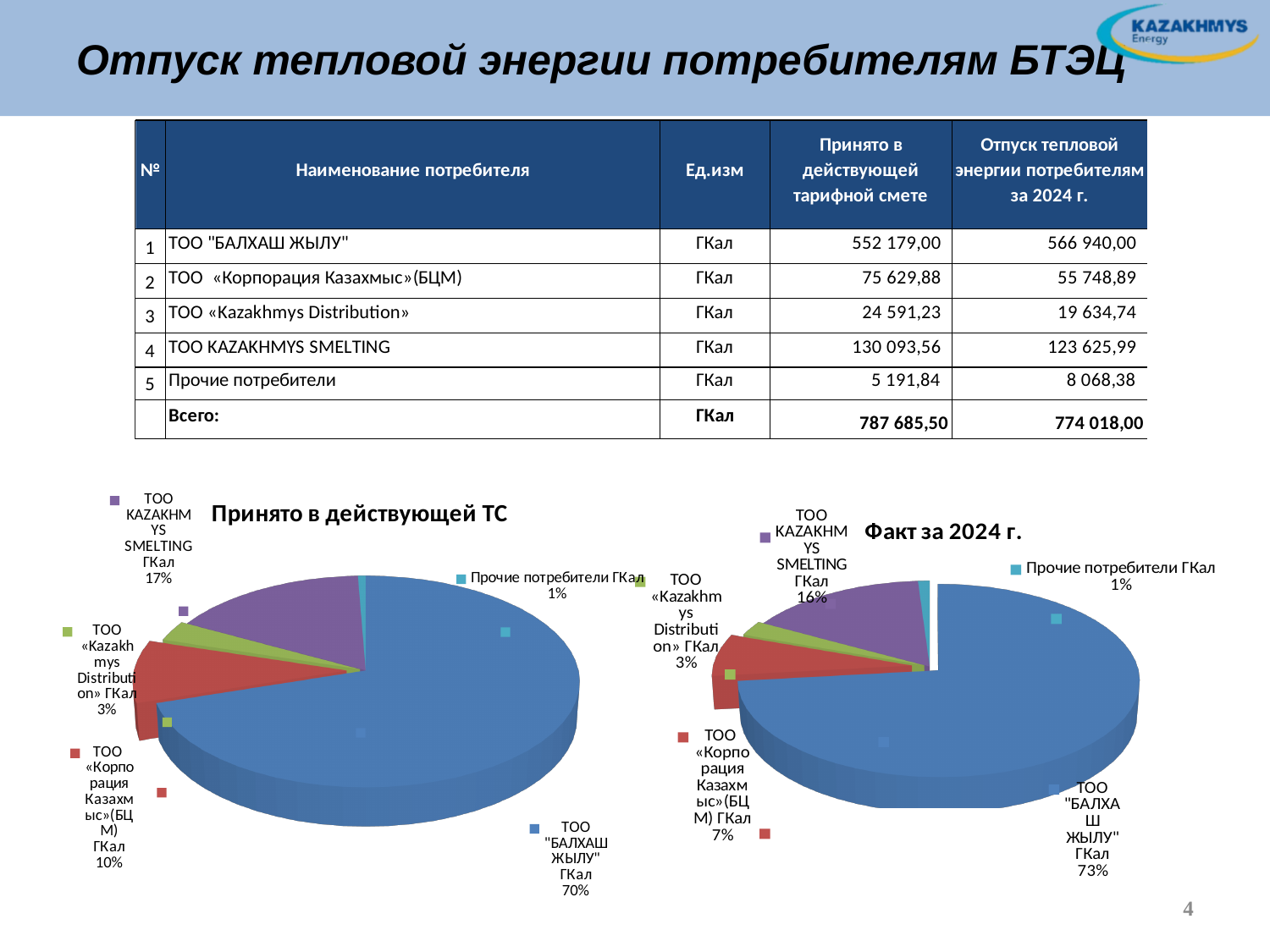
In the "Принято в действующей ТС" chart, what share does ТОО KAZAKHMYS SMELTING have? 17% In the "Факт за 2024 г." chart, what share does ТОО «Корпорация Казахмыс»(БЦМ) have? 7% In the "Факт за 2024 г." chart, what share does ТОО KAZAKHMYS SMELTING have? 16% In the "Принято в действующей ТС" chart, which category has the smallest slice? Прочие потребители In the "Принято в действующей ТС" chart, what is the difference in percentage points between ТОО KAZAKHMYS SMELTING and ТОО «Корпорация Казахмыс»(БЦМ)? 7 percentage points In the "Факт за 2024 г." chart, which category has the largest slice? ТОО "БАЛХАШ ЖЫЛУ" How many slices does the "Факт за 2024 г." pie chart have? 5 What kind of chart is the "Принято в действующей ТС" chart? pie chart In the "Факт за 2024 г." chart, which is larger: the share of ТОО KAZAKHMYS SMELTING or ТОО «Kazakhmys Distribution»? ТОО KAZAKHMYS SMELTING